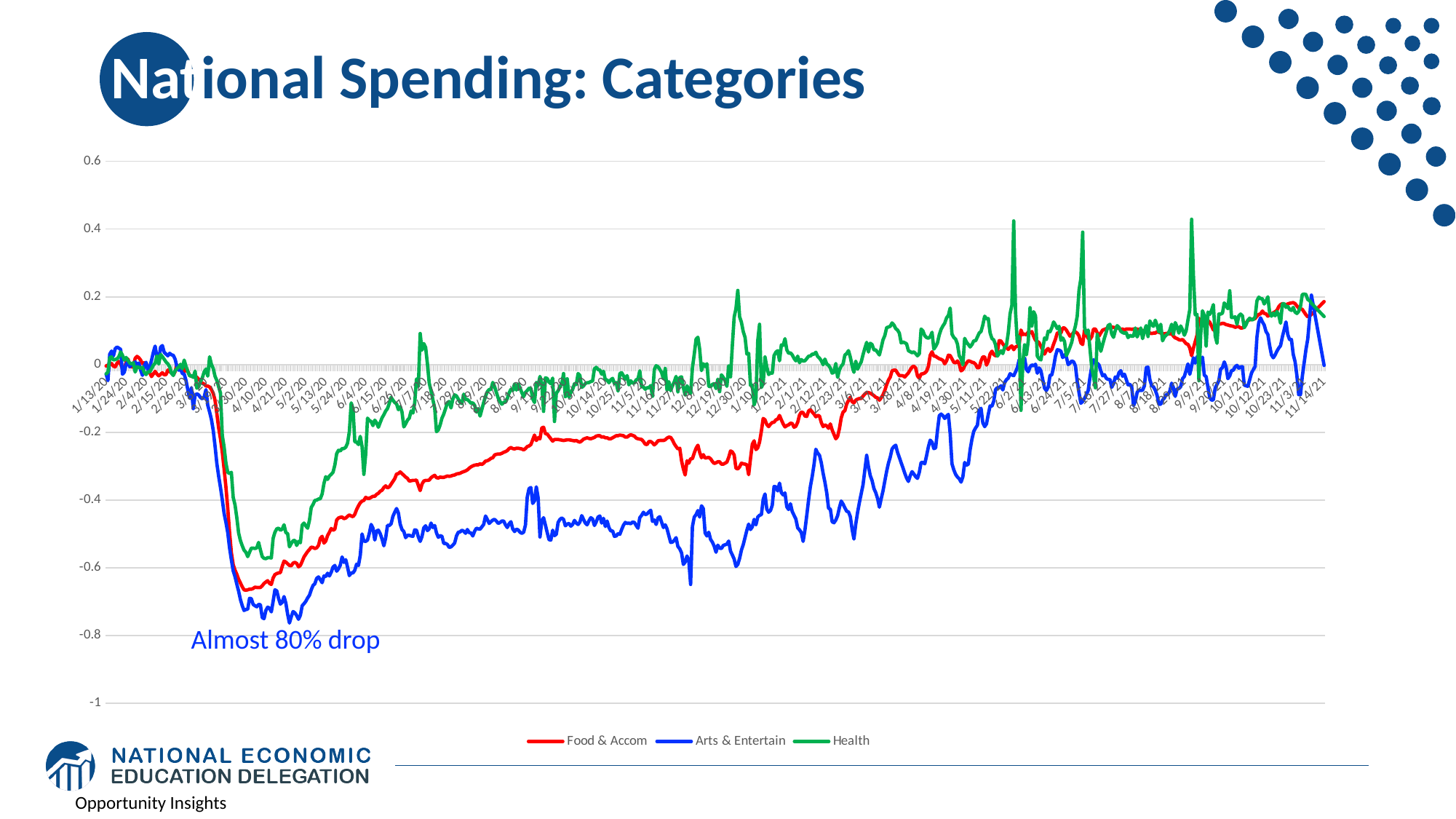
Is the lowest value of the Arts & Entertain line greater or less than -0.6? less What is the highest value shown on the vertical axis? 0.6 Do the lines generally rise or fall from mid-2020 to the end of 2021? rise What colour is the Arts & Entertain line? blue How many series does the legend list? 3 What kind of chart is shown on the slide? line chart Is the lowest value of the Food & Accom line greater or less than -0.6? less Which series stays highest during the spring 2020 drop? Health Which series falls to the lowest value in spring 2020? Arts & Entertain Is the lowest value of the Health line greater or less than -0.6? greater Which series are listed in the chart legend? Food & Accom, Arts & Entertain, Health Around 8/2020, which is higher: the Food & Accom line or the Arts & Entertain line? Food & Accom